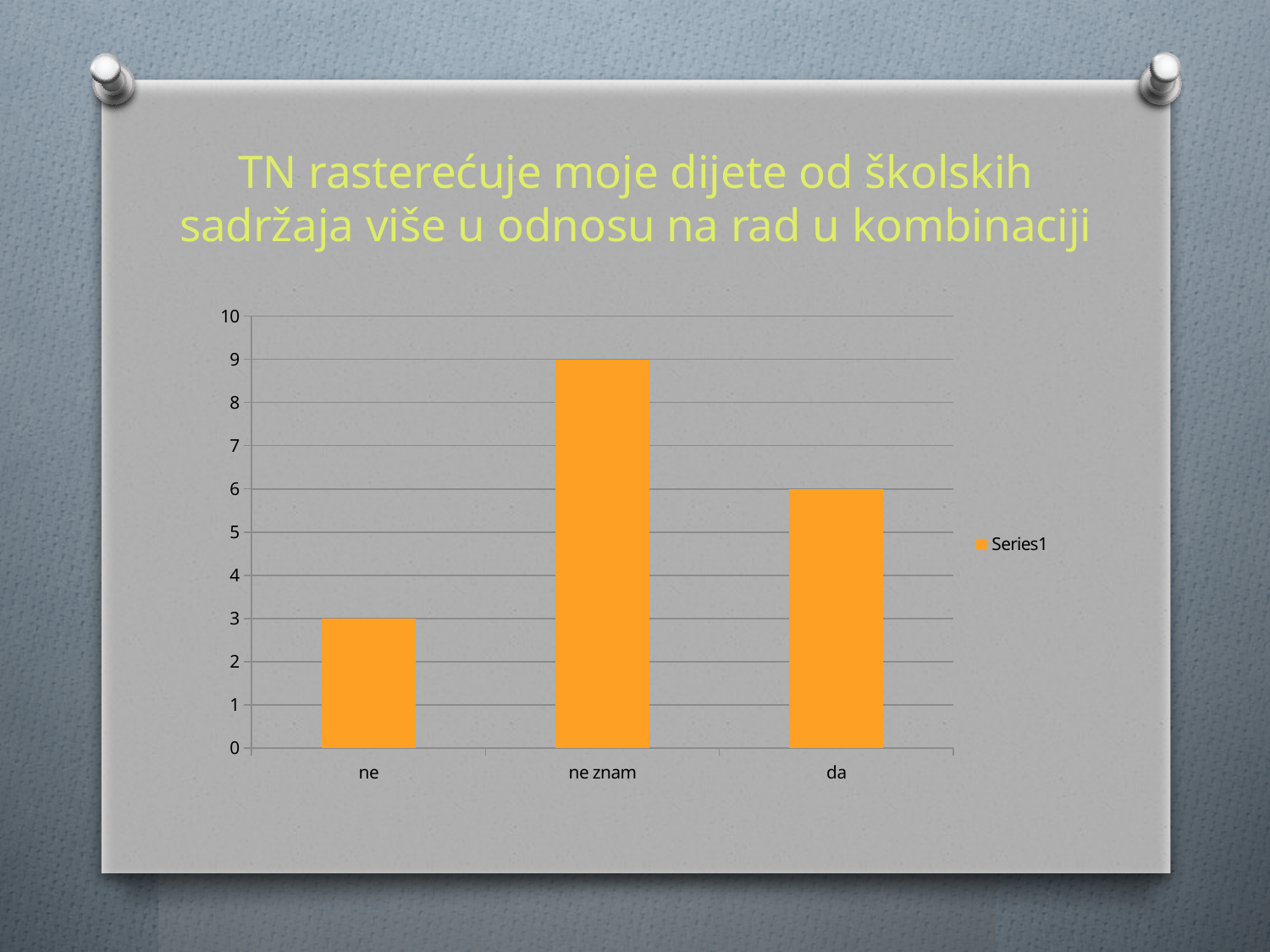
What is the value for "ne znam"? 9 What kind of chart is shown on the slide? bar chart Is the value for "ne znam" greater or less than 5? greater Which category has the highest value? ne znam How many categories are shown on the x axis? 3 What is the value for "ne"? 3 Which is larger, the value for "da" or the value for "ne"? da What is the value for "da"? 6 How many series does the legend list? 1 What is the difference between the values for "ne znam" and "da"? 3 What is the difference between the values for "da" and "ne"? 3 Which category has the lowest value? ne